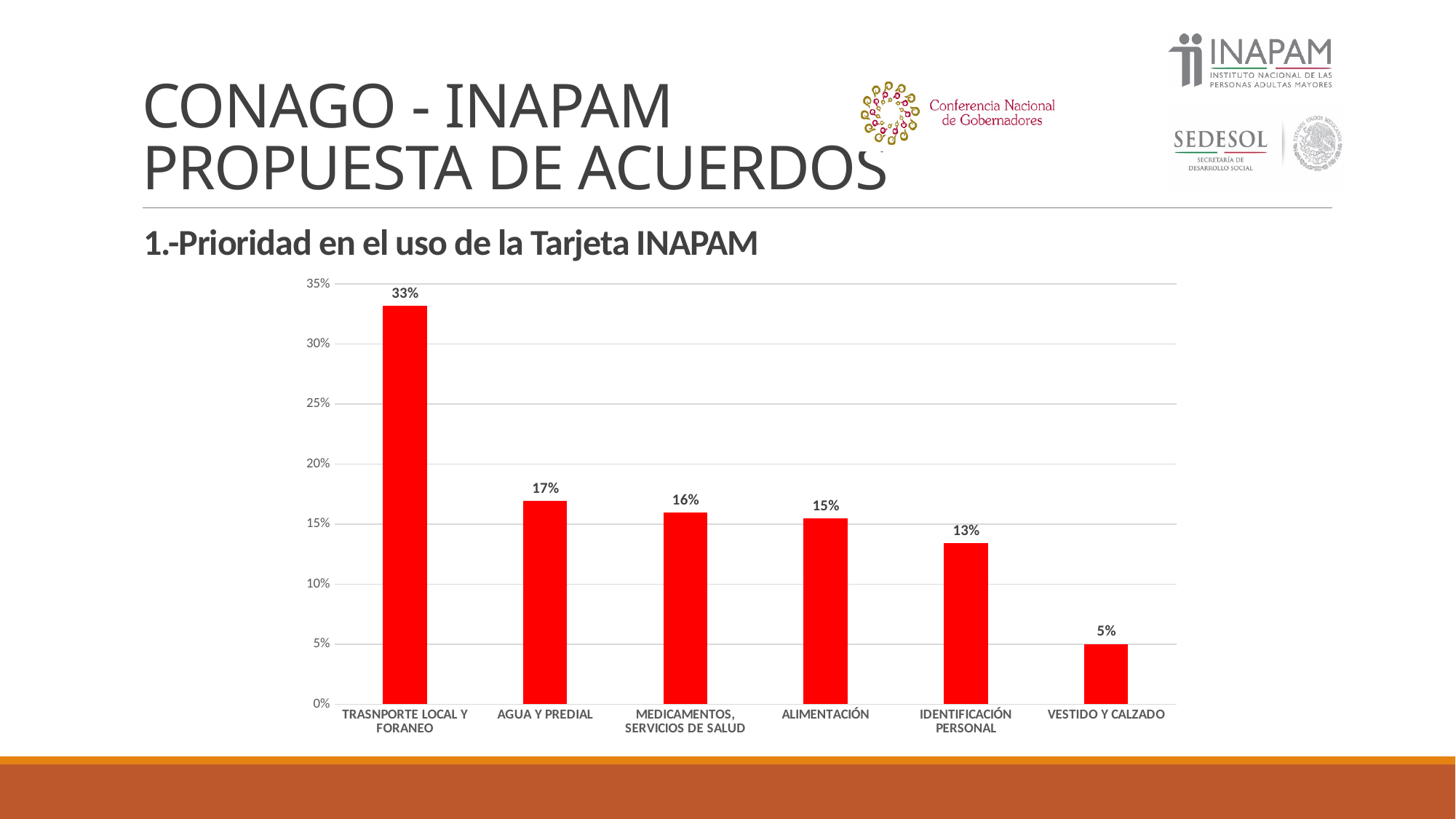
What is the value for AGUA Y PREDIAL? 17% What colour are the bars in the chart? red What is the value for VESTIDO Y CALZADO? 5% What is the difference between the values for TRASNPORTE LOCAL Y FORANEO and AGUA Y PREDIAL? 16% What is the value for MEDICAMENTOS, SERVICIOS DE SALUD? 16% Which category has the lowest value? VESTIDO Y CALZADO What kind of chart is shown on the slide? bar chart How many categories are shown on the x axis? 6 What is the value for TRASNPORTE LOCAL Y FORANEO? 33% Is the value for IDENTIFICACIÓN PERSONAL greater or less than 10%? greater Which category has the highest value? TRASNPORTE LOCAL Y FORANEO Which is larger, the value for ALIMENTACIÓN or the value for IDENTIFICACIÓN PERSONAL? ALIMENTACIÓN